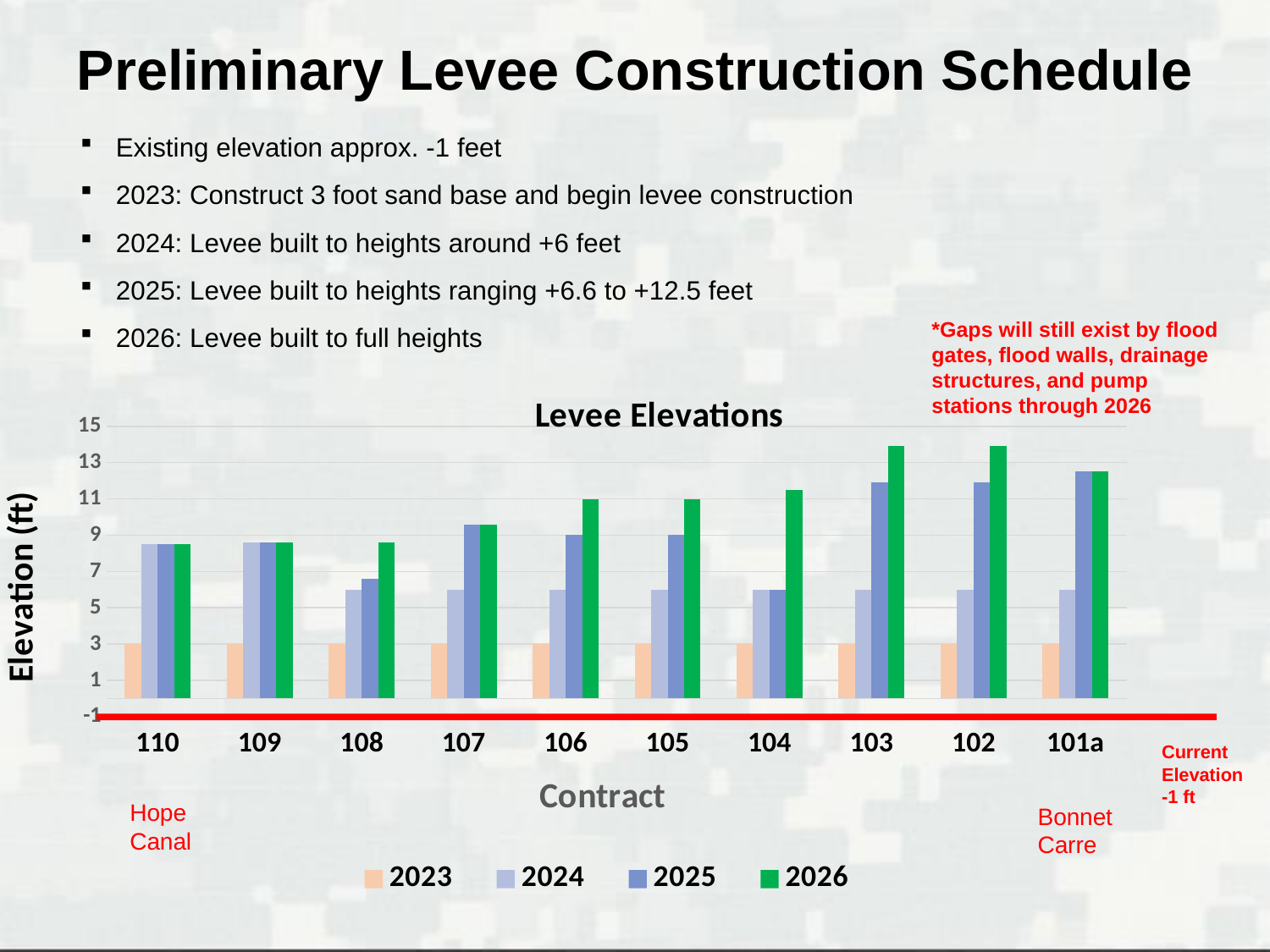
Is the 2025 elevation for contract 101a greater or less than 11? greater What kind of chart is shown on the slide? bar chart Which is larger, the 2025 elevation for contract 107 or the 2025 elevation for contract 104? contract 107 Is the 2026 elevation for contract 103 greater or less than 13? greater How many series does the chart legend list? 4 What is the label on the y axis of the chart? Elevation (ft) What is the title of the chart? Levee Elevations What is the 2023 elevation for contract 110? 3 What is the 2025 elevation for contract 106? 9 Is the 2024 elevation for contract 108 greater or less than 7? less How many contracts are shown along the x axis of the chart? 10 Which is larger, the 2026 elevation for contract 103 or the 2026 elevation for contract 108? contract 103